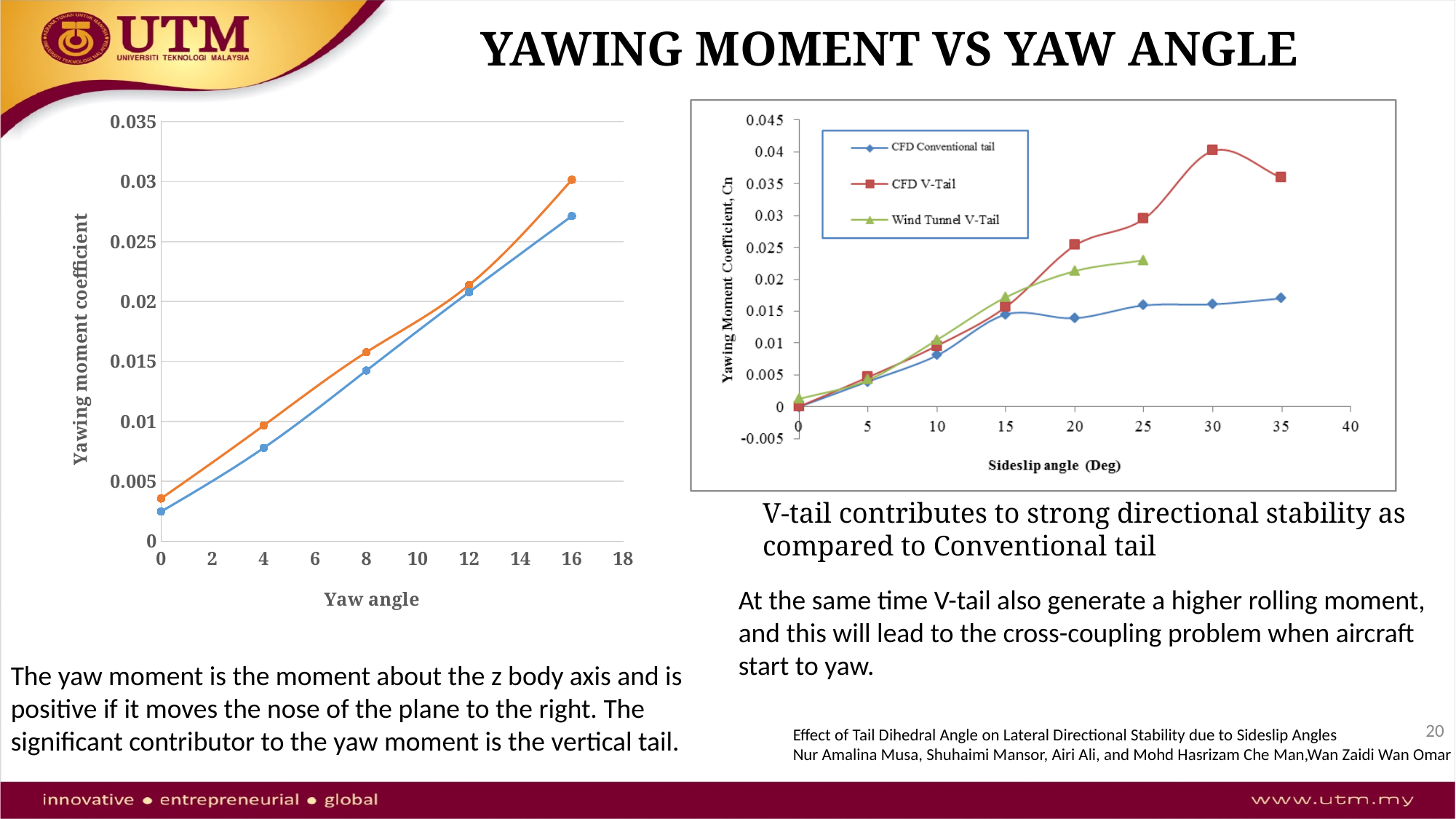
In the left chart, how many data points does each line have? 5 What kind of chart is the left chart (Yawing moment coefficient vs Yaw angle)? line chart In the left chart, is the value of the orange line at yaw angle 12 greater or less than 0.02? greater In the right chart, at sideslip angle 25, which is larger: CFD V-Tail or Wind Tunnel V-Tail? CFD V-Tail In the left chart, is the value of the blue line at yaw angle 8 greater or less than 0.015? less In the left chart, is the value of the blue line at yaw angle 16 greater or less than 0.025? greater In the right chart, how many series does the legend list? 3 In the right chart, which series reaches the highest yawing moment coefficient? CFD V-Tail In the right chart, how many data points does the Wind Tunnel V-Tail series have? 6 In the left chart, do the values rise or fall as the yaw angle increases? rise In the right chart, what is the title of the x axis? Sideslip angle (Deg)